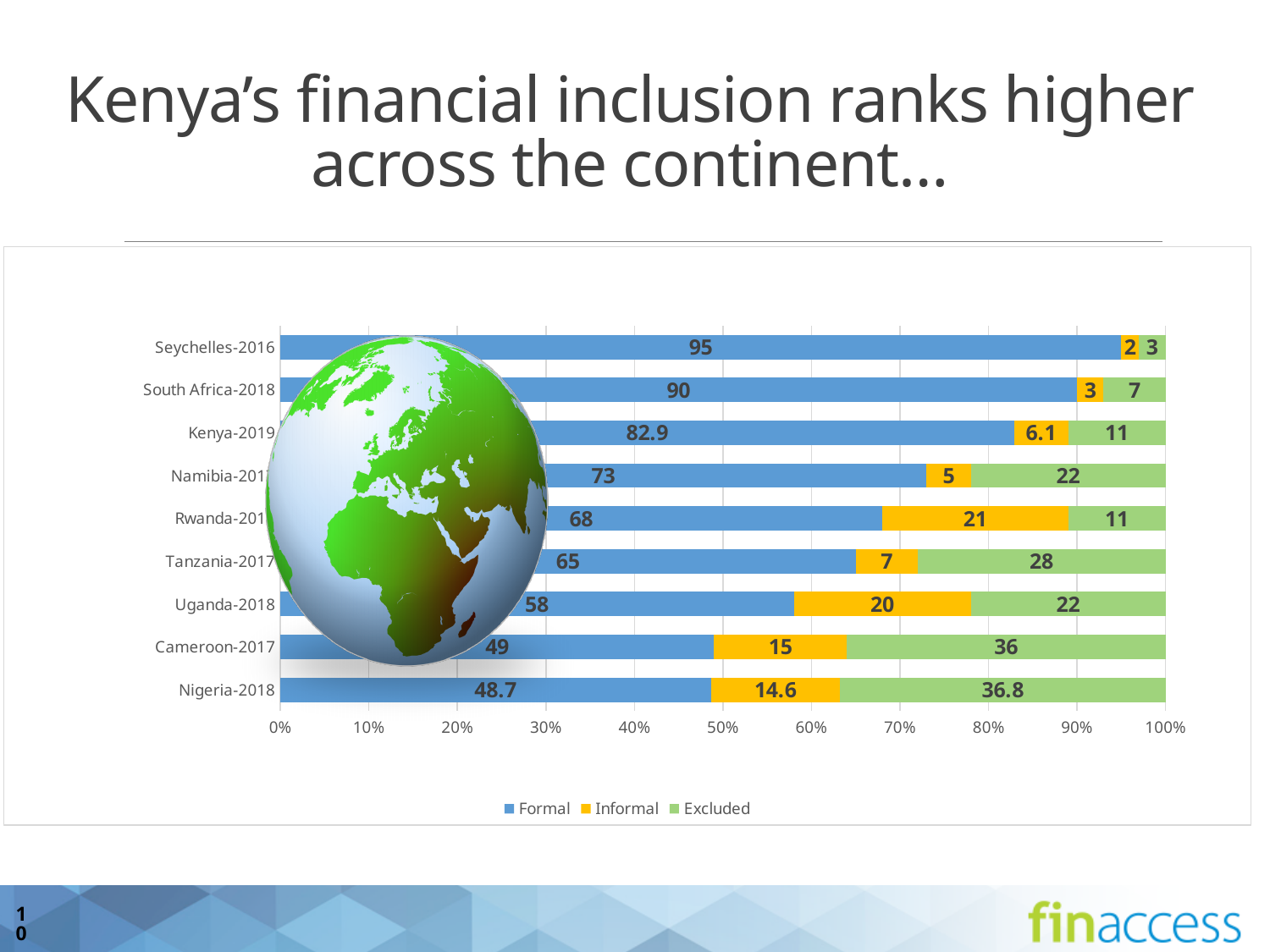
What is the Informal value for Uganda-2018? 20 How many series does the legend list? 3 What are the three series named in the legend? Formal, Informal, Excluded What is the Formal value for Kenya-2019? 82.9 Which country has the lowest Formal value? Nigeria-2018 What is the difference between the Formal values for South Africa-2018 and Kenya-2019? 7.1 What kind of chart is shown on the slide? Bar chart How many countries are plotted on the chart? 9 Which has the larger Informal value, Tanzania-2017 or Cameroon-2017? Cameroon-2017 Which country has the highest Formal value? Seychelles-2016 What is the Excluded value for Nigeria-2018? 36.8 Which country has the highest Excluded value? Nigeria-2018